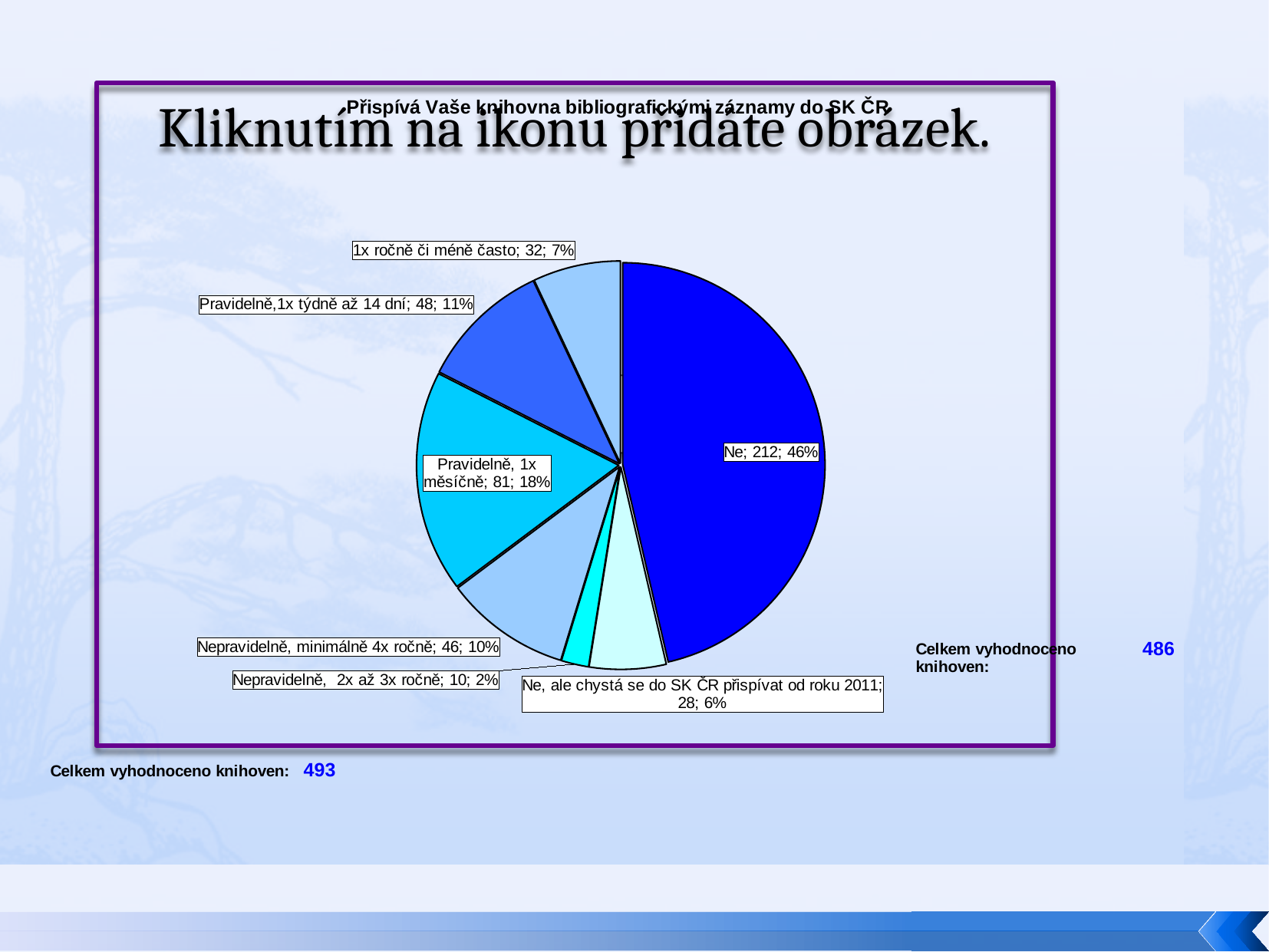
Which category has the largest slice in the pie chart? Ne What percentage is shown for "Nepravidelně, 2x až 3x ročně"? 2% What is the value for "Ne, ale chystá se do SK ČR přispívat od roku 2011"? 28 What kind of chart is shown on the slide? pie chart What is the difference between the values for "Pravidelně,1x týdně až 14 dní" and "Nepravidelně, minimálně 4x ročně"? 2 How many slices does the pie chart have? 7 Which is larger: the value for "1x ročně či méně často" or the value for "Ne, ale chystá se do SK ČR přispívat od roku 2011"? 1x ročně či méně často What share of the pie does the "Ne" slice represent? 46% How many libraries answered "Ne" in the pie chart? 212 What percentage is shown for "Pravidelně,1x týdně až 14 dní"? 11% Which category has the smallest slice in the pie chart? Nepravidelně, 2x až 3x ročně What is the value for "Pravidelně, 1x měsíčně"? 81